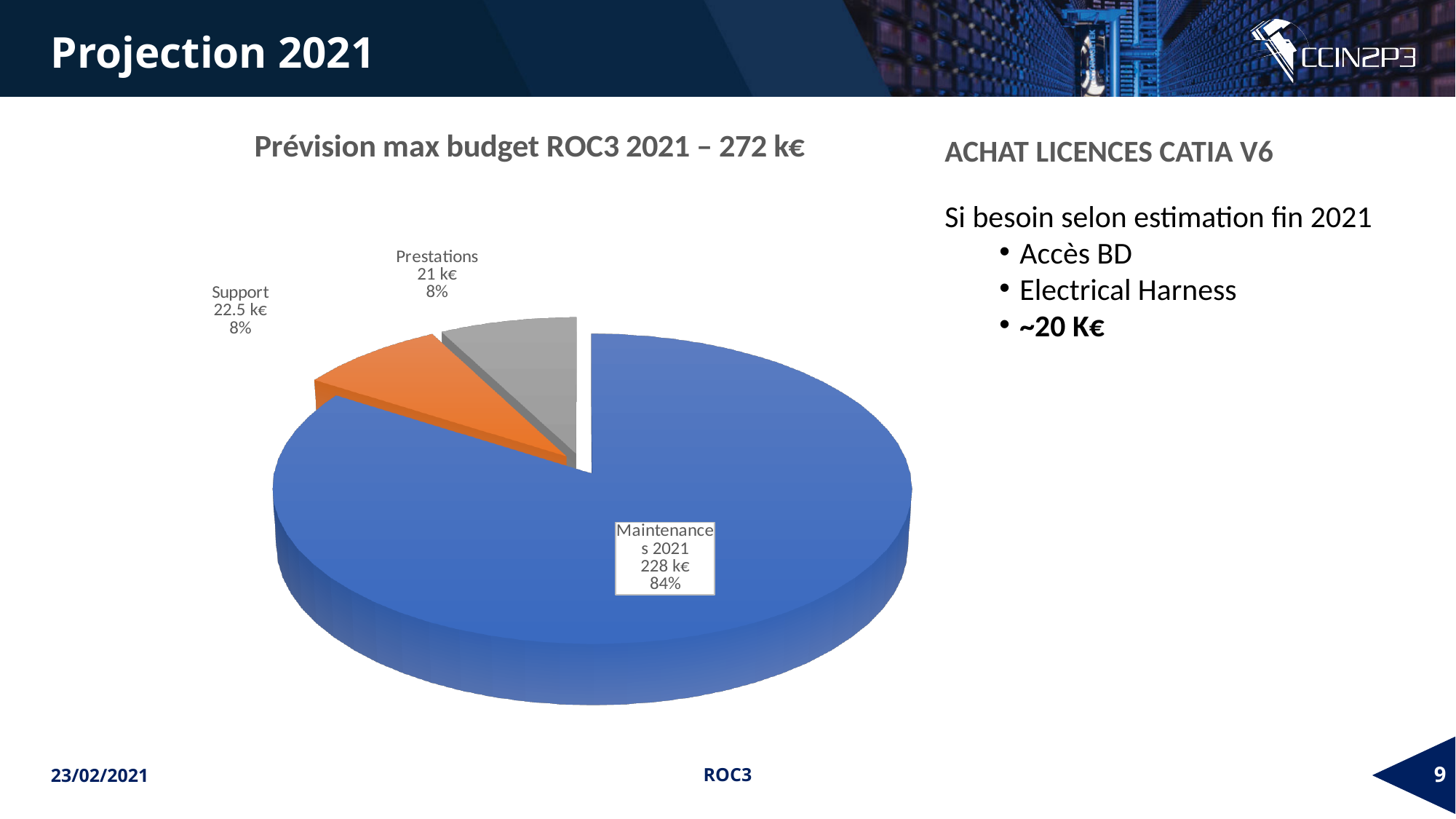
Which colour is the Support slice? Orange What is the value for Support? 22.5 k€ What is the value for Prestations? 21 k€ Which category has the largest slice? Maintenances 2021 What is the difference in value between Support and Prestations? 1.5 k€ How many slices does the pie chart have? 3 What is the title of the chart? Prévision max budget ROC3 2021 – 272 k€ What is the difference in value between Maintenances 2021 and Support? 205.5 k€ What share of the pie does Support represent? 8% What kind of chart is shown on the slide? Pie chart What share of the pie does Maintenances 2021 represent? 84% What is the value for Maintenances 2021? 228 k€